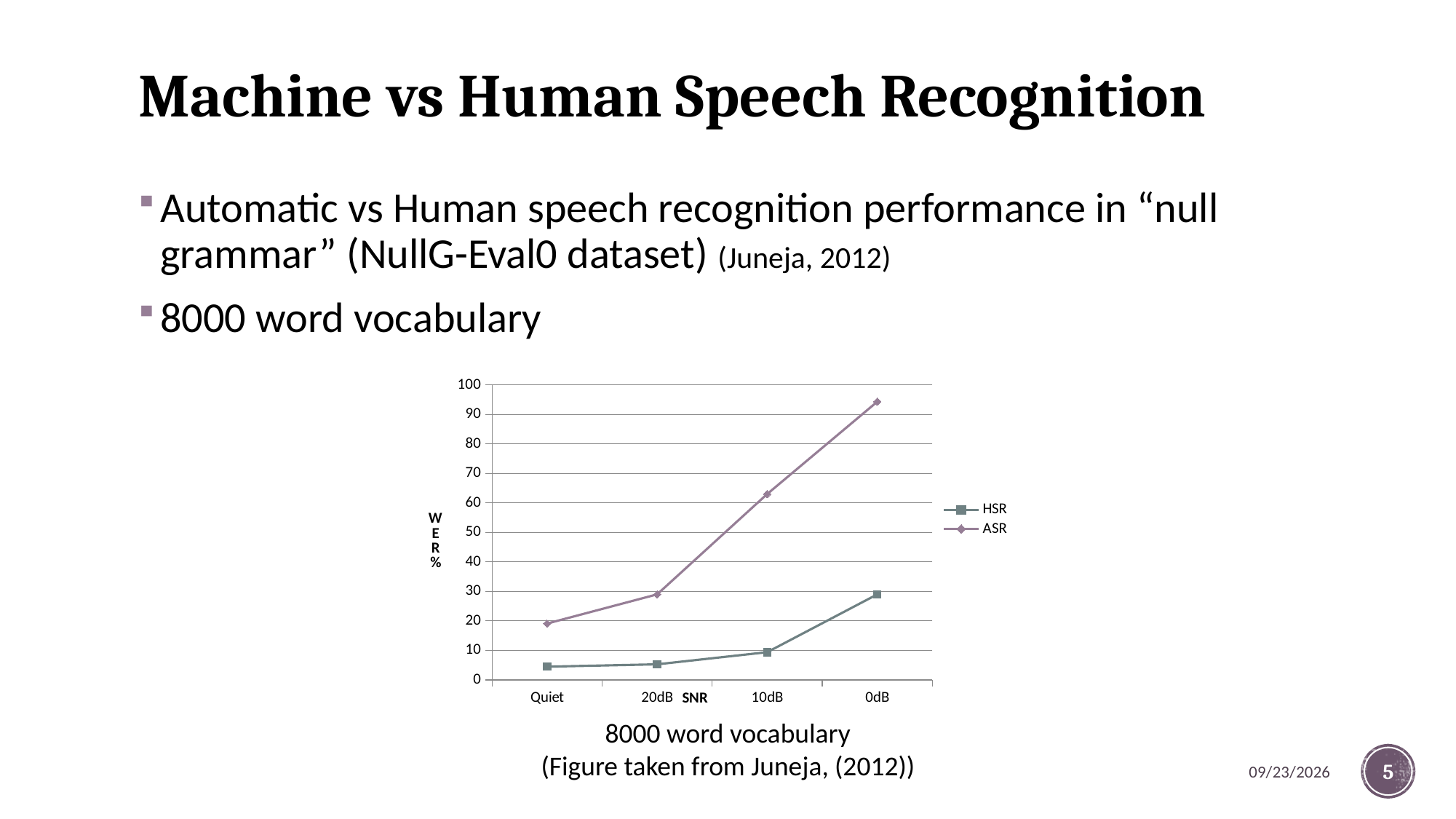
Do the WER% values for ASR rise or fall moving from Quiet to 0dB along the x axis? rise Is the ASR value at 10dB greater or less than 50? greater Which SNR condition has the highest ASR WER%? 0dB Is the HSR value at 0dB greater or less than 20? greater Is the ASR value at 0dB greater or less than 90? greater At 10dB, which series has the larger WER%, HSR or ASR? ASR Which SNR condition has the highest HSR WER%? 0dB What kind of chart is shown on the slide? line chart How many SNR conditions are plotted along the x axis? 4 How many series does the chart legend list? 2 Which SNR condition has the lowest ASR WER%? Quiet